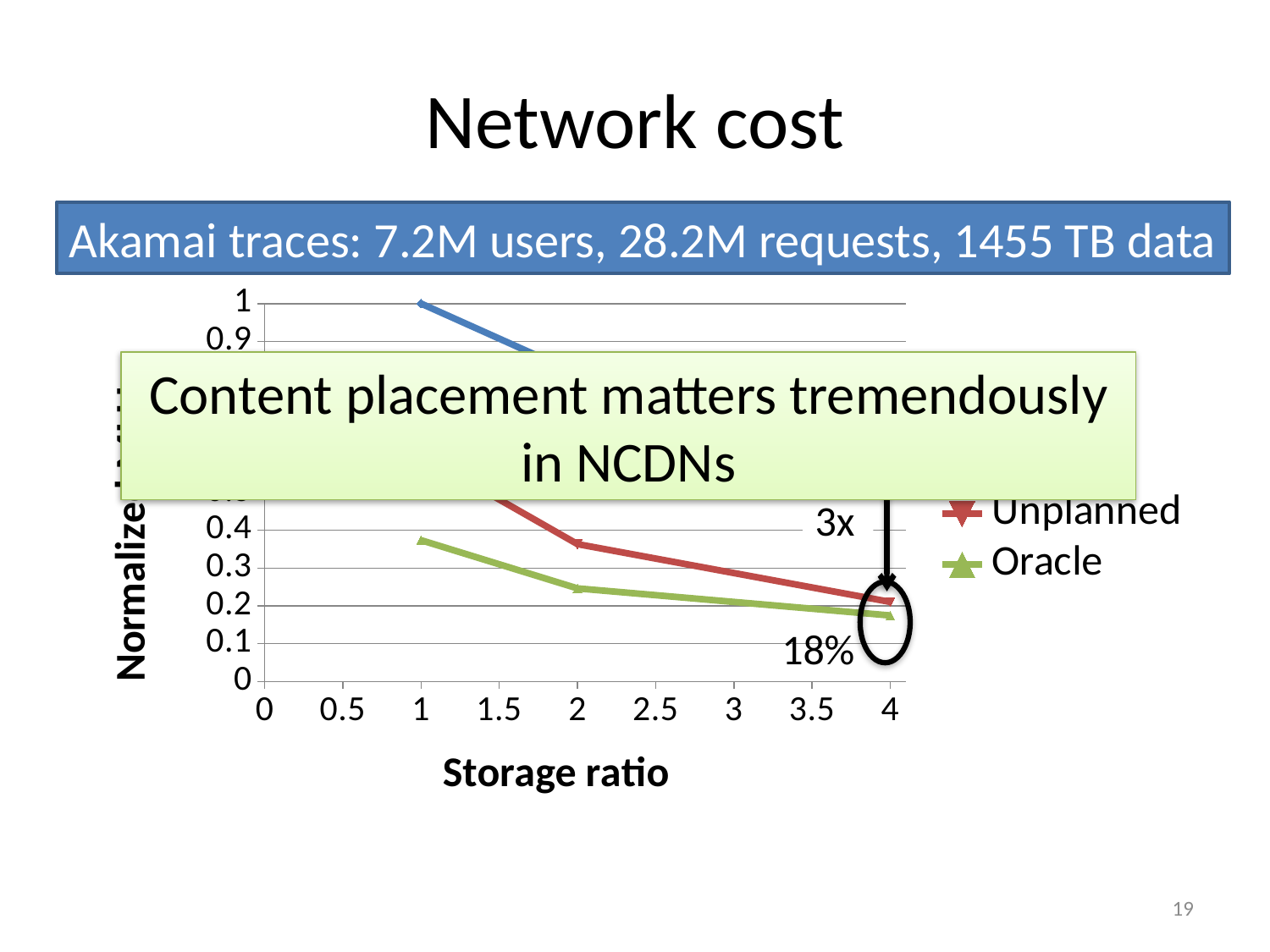
What is the label of the x axis of the chart? Storage ratio At storage ratio 2, which series has the higher value, Unplanned or Oracle? Unplanned What kind of chart is shown on the slide? line chart Is the value for Unplanned at storage ratio 4 greater or less than 0.3? less Is the value for Oracle at storage ratio 1 greater or less than 0.5? less What is the value of the blue series at storage ratio 1? 1 How many data points are plotted for the Oracle series? 3 Which two series names are readable in the chart's legend? Unplanned and Oracle Does the Oracle series rise or fall as the storage ratio increases? fall Is the value for Oracle at storage ratio 2 greater or less than 0.3? less What percentage is annotated next to the circled points at storage ratio 4? 18%